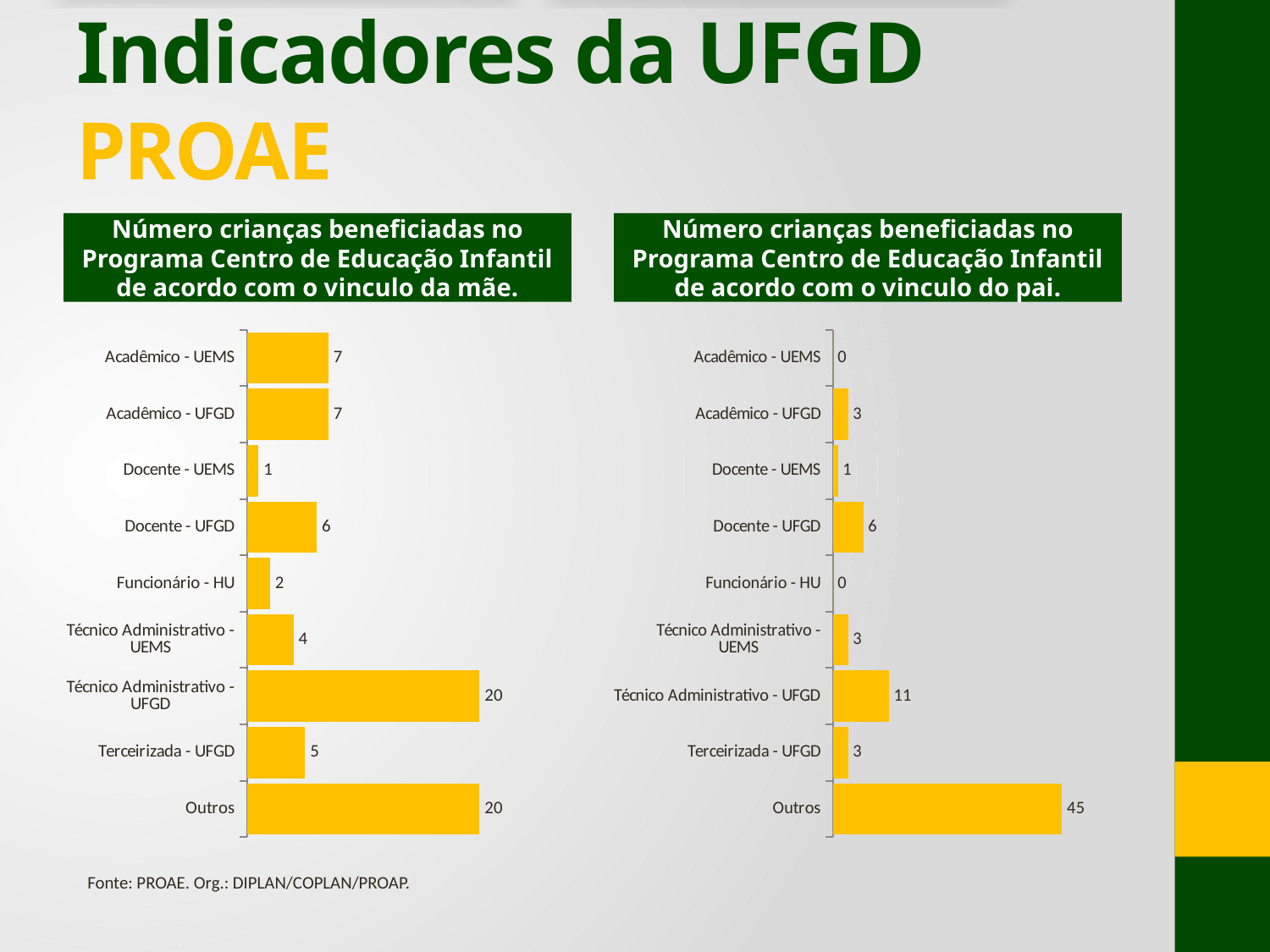
In the right chart (vinculo do pai), which category has the highest value? Outros In the left chart (vinculo da mãe), which category has the lowest value? Docente - UEMS What is the title of the left chart? Número crianças beneficiadas no Programa Centro de Educação Infantil de acordo com o vinculo da mãe. In the left chart (vinculo da mãe), what is the value for Funcionário - HU? 2 In the left chart (vinculo da mãe), what is the difference between Outros and Terceirizada - UFGD? 15 In the right chart (vinculo do pai), what is the value for Técnico Administrativo - UFGD? 11 In the left chart (vinculo da mãe), what is the value for Técnico Administrativo - UFGD? 20 In the right chart (vinculo do pai), which is larger: Docente - UFGD or Acadêmico - UFGD? Docente - UFGD In the right chart (vinculo do pai), what is the value for Outros? 45 What kind of chart is the right chart (vinculo do pai)? Bar chart In the left chart (vinculo da mãe), how many categories are shown? 9 In the right chart (vinculo do pai), what is the difference between Outros and Técnico Administrativo - UFGD? 34